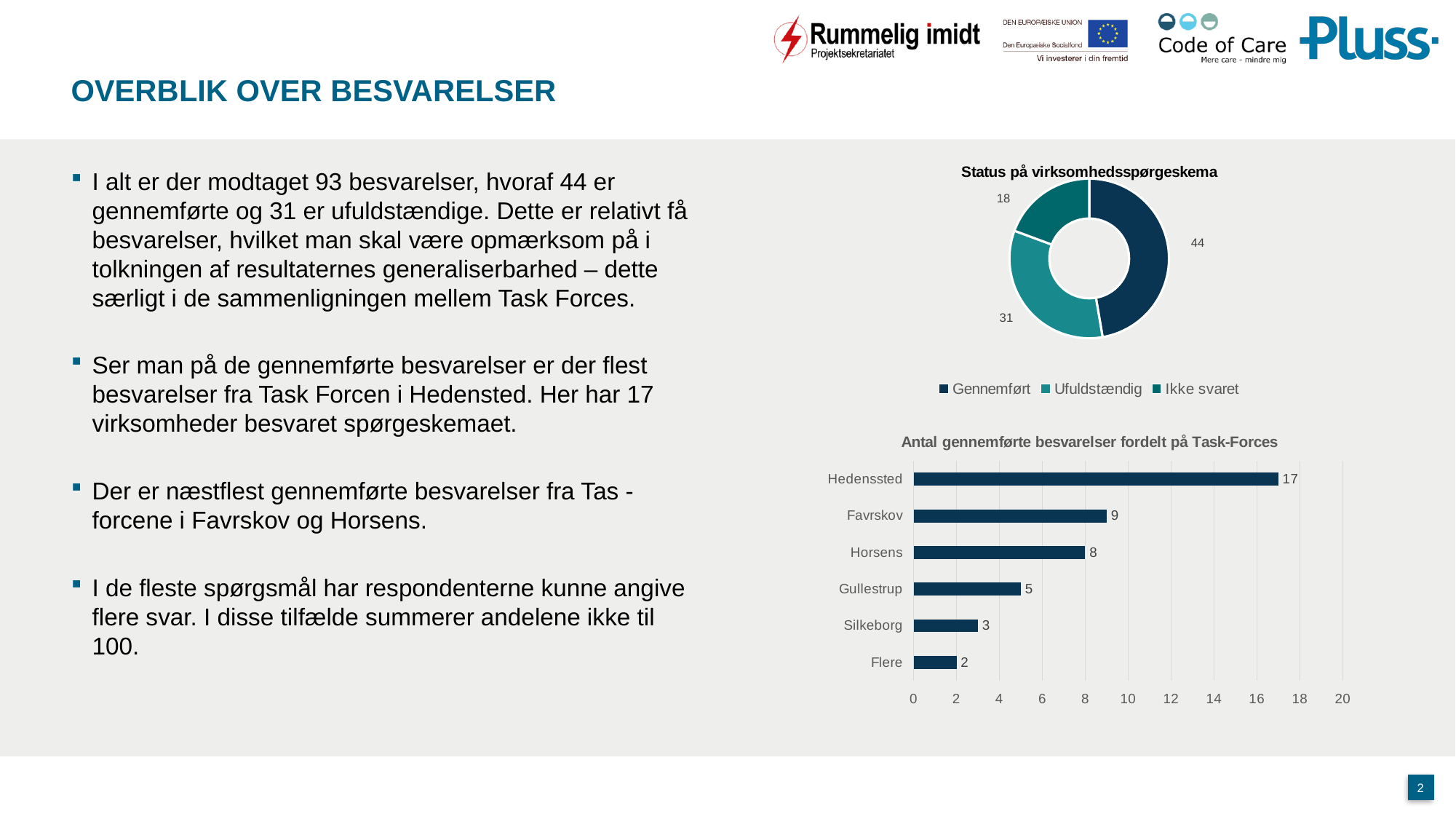
In the chart 'Antal gennemførte besvarelser fordelt på Task-Forces', what is the value for Horsens? 8 In the chart 'Antal gennemførte besvarelser fordelt på Task-Forces', which category has the lowest value? Flere In the chart 'Status på virksomhedsspørgeskema', how many categories does the legend list? 3 In the chart 'Status på virksomhedsspørgeskema', what is the value for Ikke svaret? 18 What kind of chart is 'Status på virksomhedsspørgeskema'? Doughnut chart In the chart 'Antal gennemførte besvarelser fordelt på Task-Forces', what is the difference between Hedenssted and Favrskov? 8 What kind of chart is 'Antal gennemførte besvarelser fordelt på Task-Forces'? Bar chart In the chart 'Antal gennemførte besvarelser fordelt på Task-Forces', how many categories are shown? 6 In the chart 'Status på virksomhedsspørgeskema', what is the value for Gennemført? 44 In the chart 'Status på virksomhedsspørgeskema', what is the difference between Gennemført and Ufuldstændig? 13 In the chart 'Status på virksomhedsspørgeskema', which category has the lowest value? Ikke svaret In the chart 'Antal gennemførte besvarelser fordelt på Task-Forces', which category has the highest value? Hedenssted